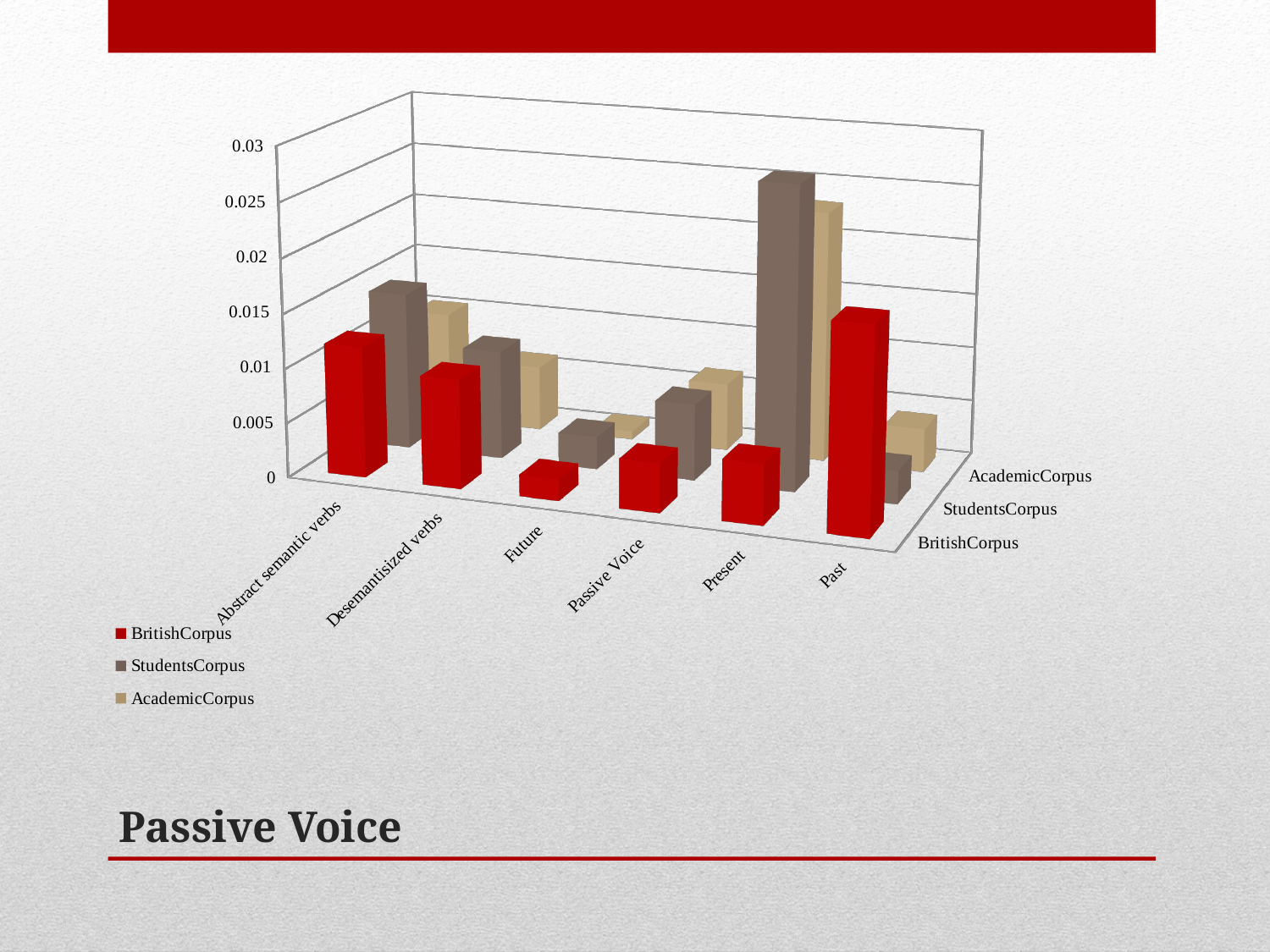
For the Past category, which is larger: the StudentsCorpus value or the BritishCorpus value? BritishCorpus How many series does the legend list? 3 How many categories are shown along the x axis? 6 Is the AcademicCorpus value for Past greater or less than 0.015? less For BritishCorpus, which is larger: the value for Abstract semantic verbs or the value for Future? Abstract semantic verbs What kind of chart is shown on the slide? bar chart What colour represents BritishCorpus in the legend? red Which category has the lowest BritishCorpus value? Future Is the StudentsCorpus value for Past greater or less than 0.02? less Is the BritishCorpus value for Future greater or less than 0.005? less Which category has the highest StudentsCorpus value? Present